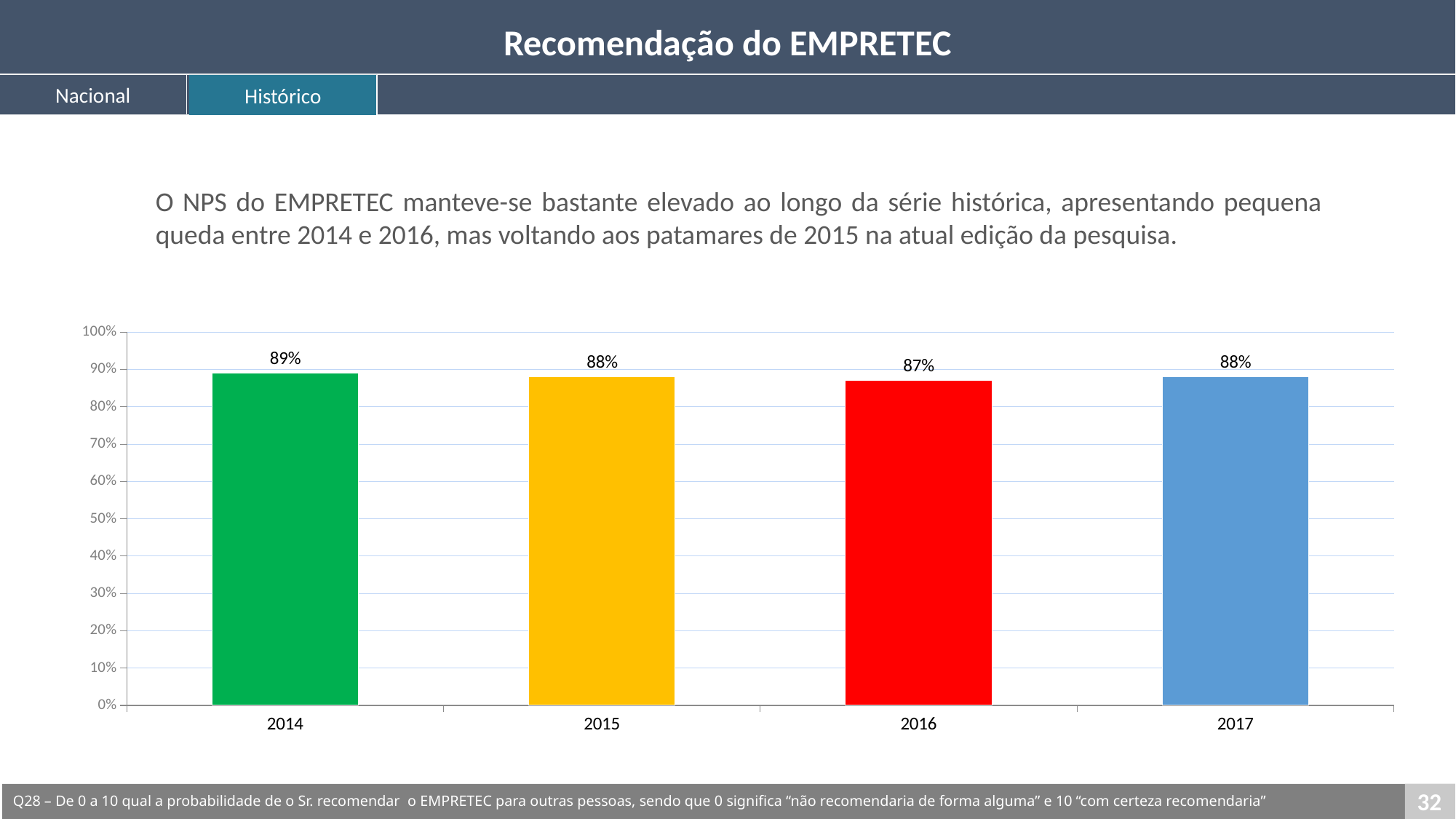
Which year has the lowest value in the chart? 2016 Which is larger, the value for 2015 or the value for 2016? 2015 How many years are shown on the x axis of the chart? 4 What is the value shown for 2017? 88% How do the values change from 2014 to 2016? They fall Is the value for 2016 greater or less than 80%? greater What is the value shown for 2014? 89% What kind of chart is shown on the slide? Bar chart What colour is the bar for 2016? Red What is the difference between the values for 2014 and 2016? 2 percentage points What is the value shown for 2016? 87% Which year has the highest value in the chart? 2014